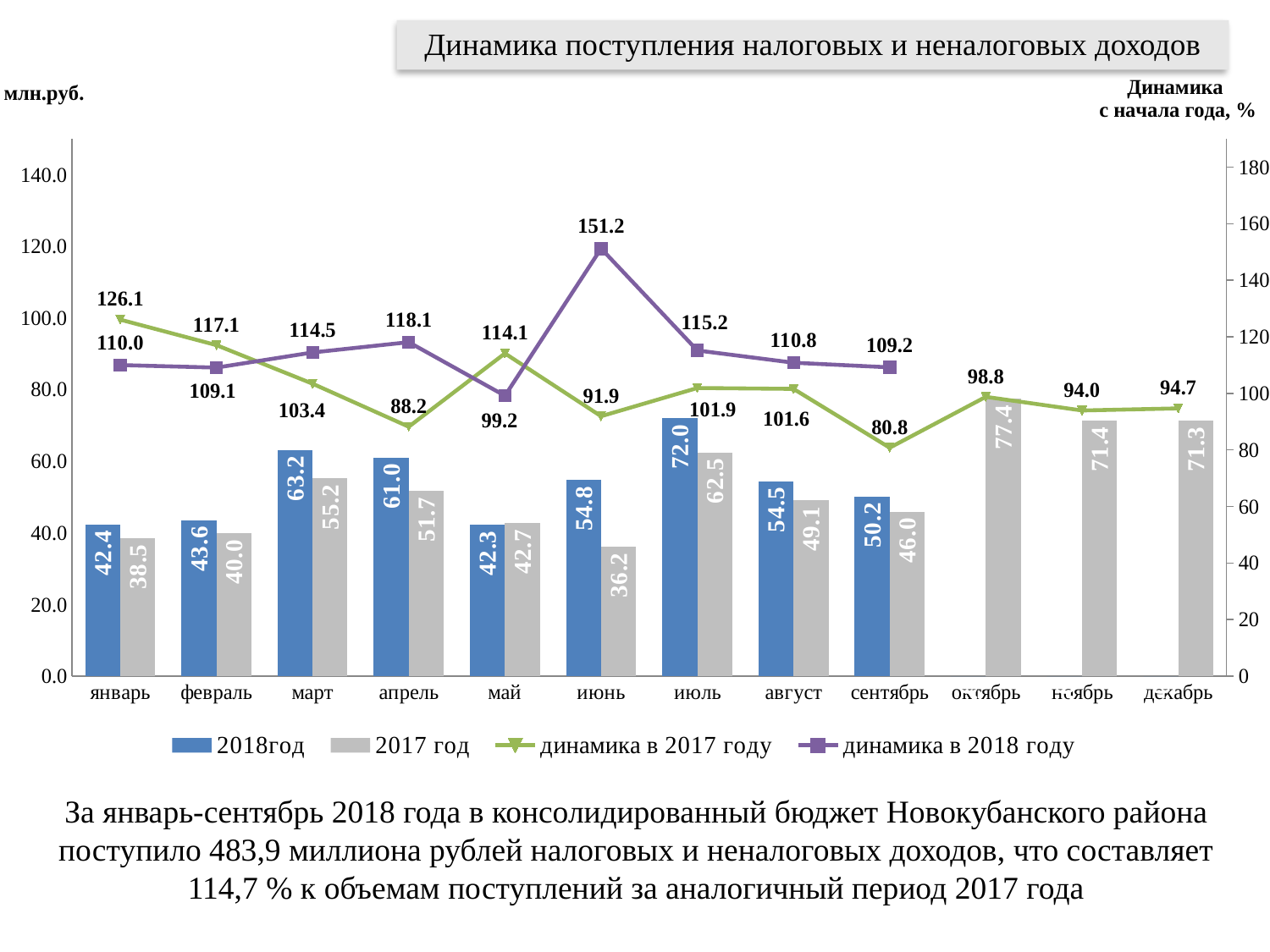
How many series does the legend list? 4 For май, which is larger: the 2018год value or the 2017 год value? 2017 год Which month has the lowest value in the 2017 год series? июнь What is the value of the динамика в 2017 году series for сентябрь? 80.8 What is the value of the 2018год series for июль? 72.0 What is the difference between the 2018год and 2017 год values for июль? 9.5 How many months are shown on the x axis? 12 Which month has the highest value in the 2018год series? июль Which month has the lowest value in the динамика в 2017 году series? сентябрь What kind of chart is shown on the slide? Combined bar and line chart What is the value of the динамика в 2018 году series for июнь? 151.2 What is the value of the 2017 год series for октябрь? 77.4